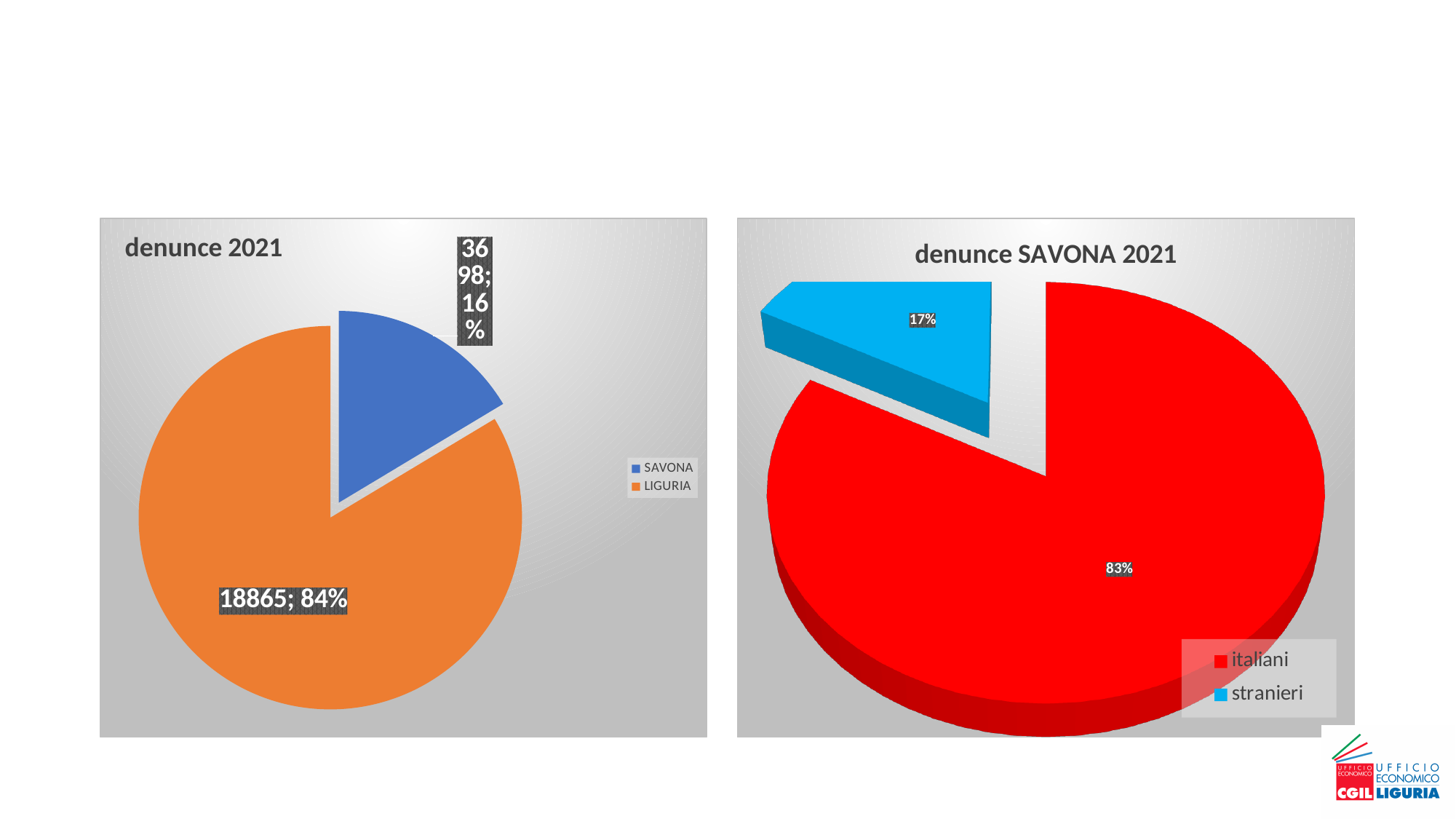
In the 'denunce 2021' chart, what is the difference between the LIGURIA value and the SAVONA value? 15167 In the 'denunce SAVONA 2021' chart, what percentage is shown for italiani? 83% In the 'denunce SAVONA 2021' chart, which category has the smallest slice? stranieri What kind of chart is the 'denunce SAVONA 2021' chart? Pie chart In the 'denunce 2021' chart, what value is shown for SAVONA? 3698 In the 'denunce 2021' chart, what percentage share does SAVONA have? 16% How many categories does the legend of the 'denunce 2021' chart list? 2 In the 'denunce 2021' chart, what value is shown for LIGURIA? 18865 In the 'denunce 2021' chart, what percentage share does LIGURIA have? 84% In the 'denunce 2021' chart, which category has the largest slice? LIGURIA In the 'denunce SAVONA 2021' chart, what colour is the stranieri slice? Light blue